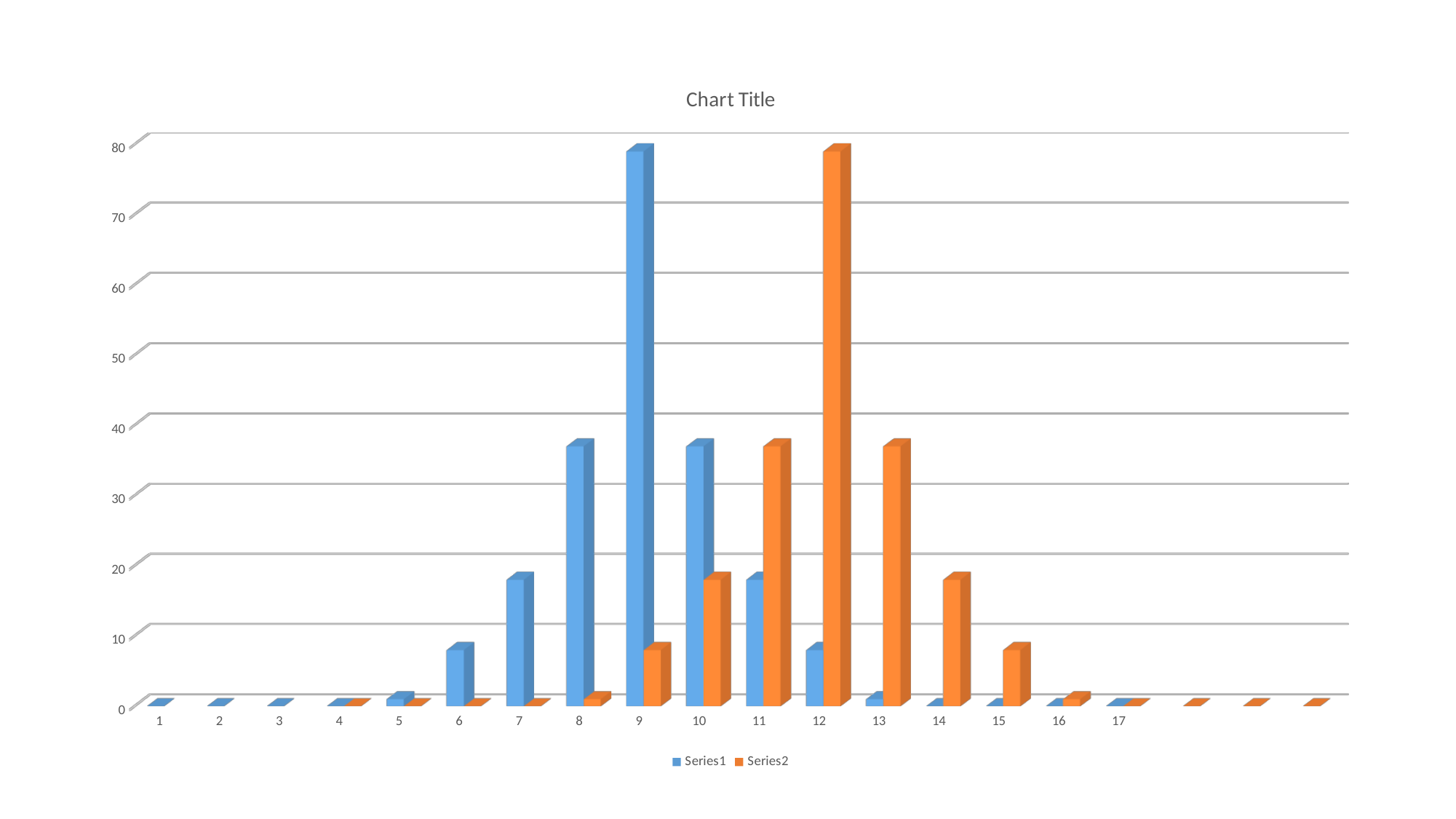
At which category does Series2 reach its highest value? 12 Is the value for Series2 at category 13 greater or less than 40? less Is the value for Series1 at category 7 greater or less than 20? less At which category does Series1 reach its highest value? 9 What is the title of the chart? Chart Title What are the two entries listed in the legend? Series1 and Series2 Is the value for Series1 at category 9 greater or less than 70? greater At category 12, which series has the larger value, Series1 or Series2? Series2 What kind of chart is shown on the slide? bar chart At category 8, which series has the larger value, Series1 or Series2? Series1 How many series does the legend list? 2